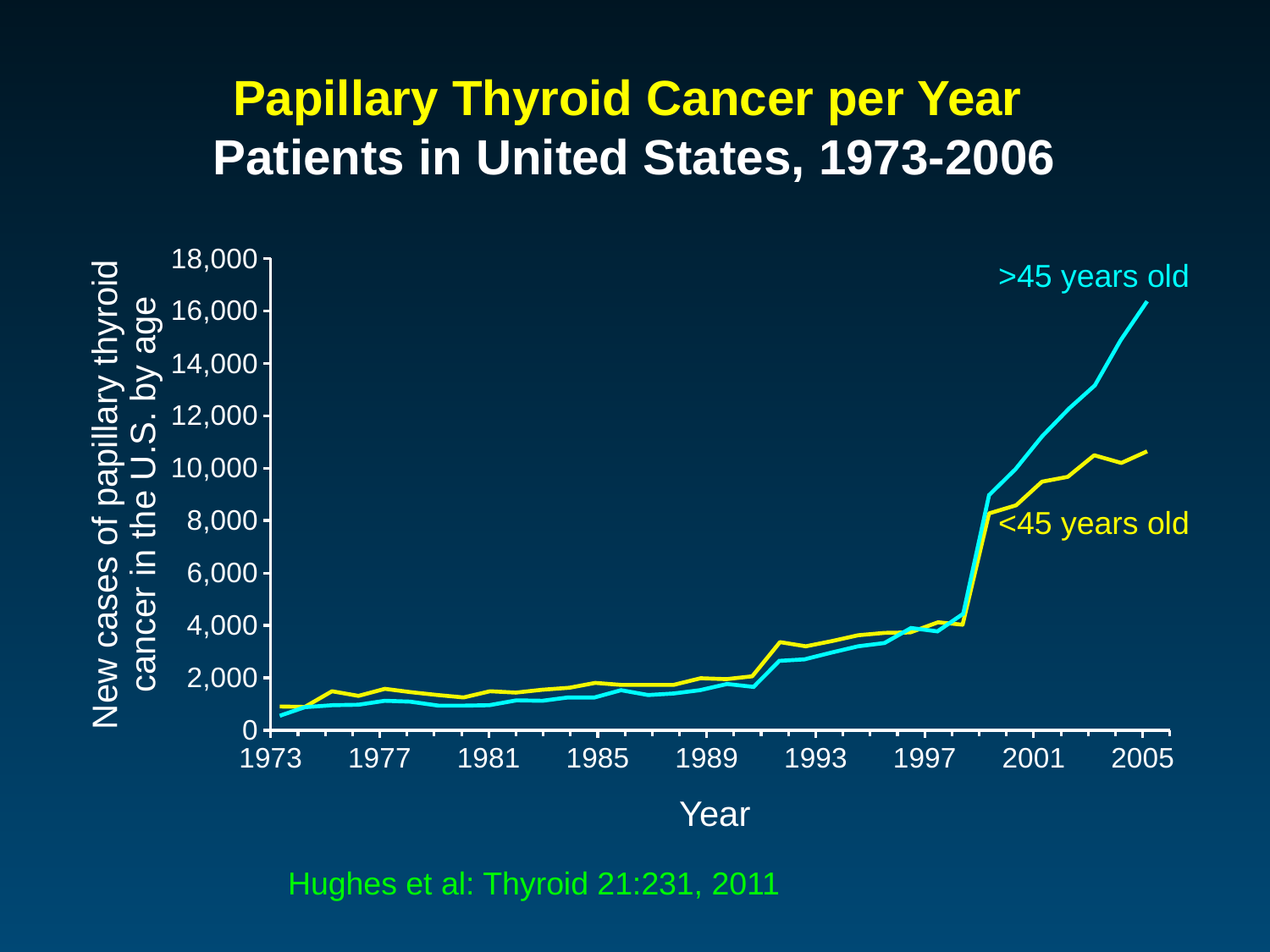
Which series is drawn in yellow? <45 years old What is the title of the chart on the slide? Papillary Thyroid Cancer per Year Patients in United States, 1973-2006 Do the values for the >45 years old series rise or fall from 1973 to 2005? rise Is the value for <45 years old in 1997 greater or less than 6,000? less Is the value for >45 years old in 2005 greater or less than 14,000? greater What kind of chart is shown on the slide? line chart Is the value for >45 years old in 1973 greater or less than 2,000? less In 1985, which series has the higher value, >45 years old or <45 years old? <45 years old How many series are plotted on the chart? 2 In 2005, which series has the higher value, >45 years old or <45 years old? >45 years old